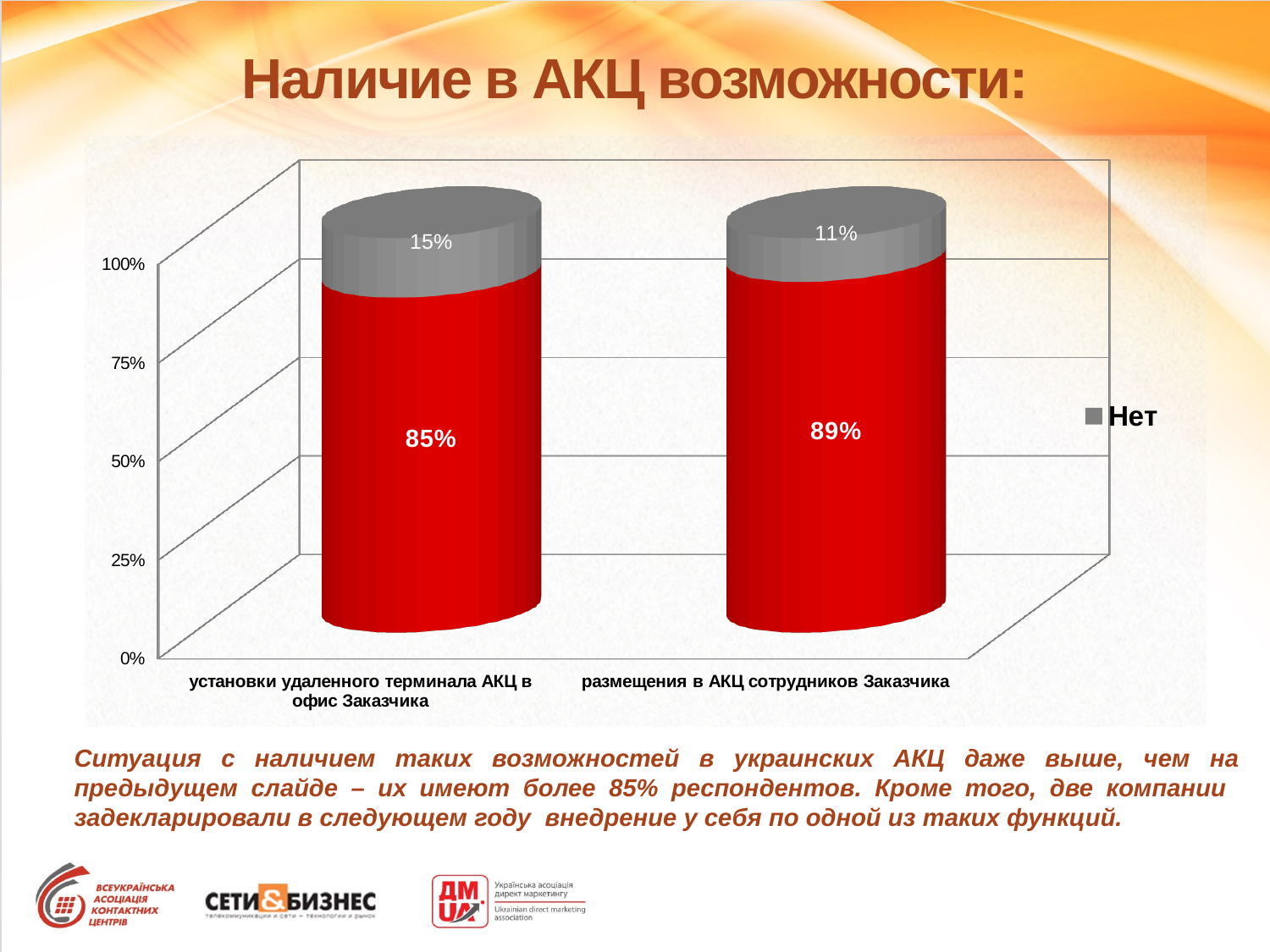
How many categories are shown on the x axis of the chart? 2 What is the value of the "Нет" (grey) segment for "установки удаленного терминала АКЦ в офис Заказчика"? 15% What is the difference between the red-segment values of the two categories? 4% Which category has the lower red-segment value? установки удаленного терминала АКЦ в офис Заказчика Which series name is shown in the chart legend? Нет What is the value of the red segment for "установки удаленного терминала АКЦ в офис Заказчика"? 85% What kind of chart is shown on the slide? Stacked bar chart What is the value of the "Нет" (grey) segment for "размещения в АКЦ сотрудников Заказчика"? 11% Is the red segment for "размещения в АКЦ сотрудников Заказчика" larger or smaller than the red segment for "установки удаленного терминала АКЦ в офис Заказчика"? larger What is the total of the stacked bar for "размещения в АКЦ сотрудников Заказчика"? 100% What is the value of the red segment for "размещения в АКЦ сотрудников Заказчика"? 89% Which category has the higher "Нет" value? установки удаленного терминала АКЦ в офис Заказчика